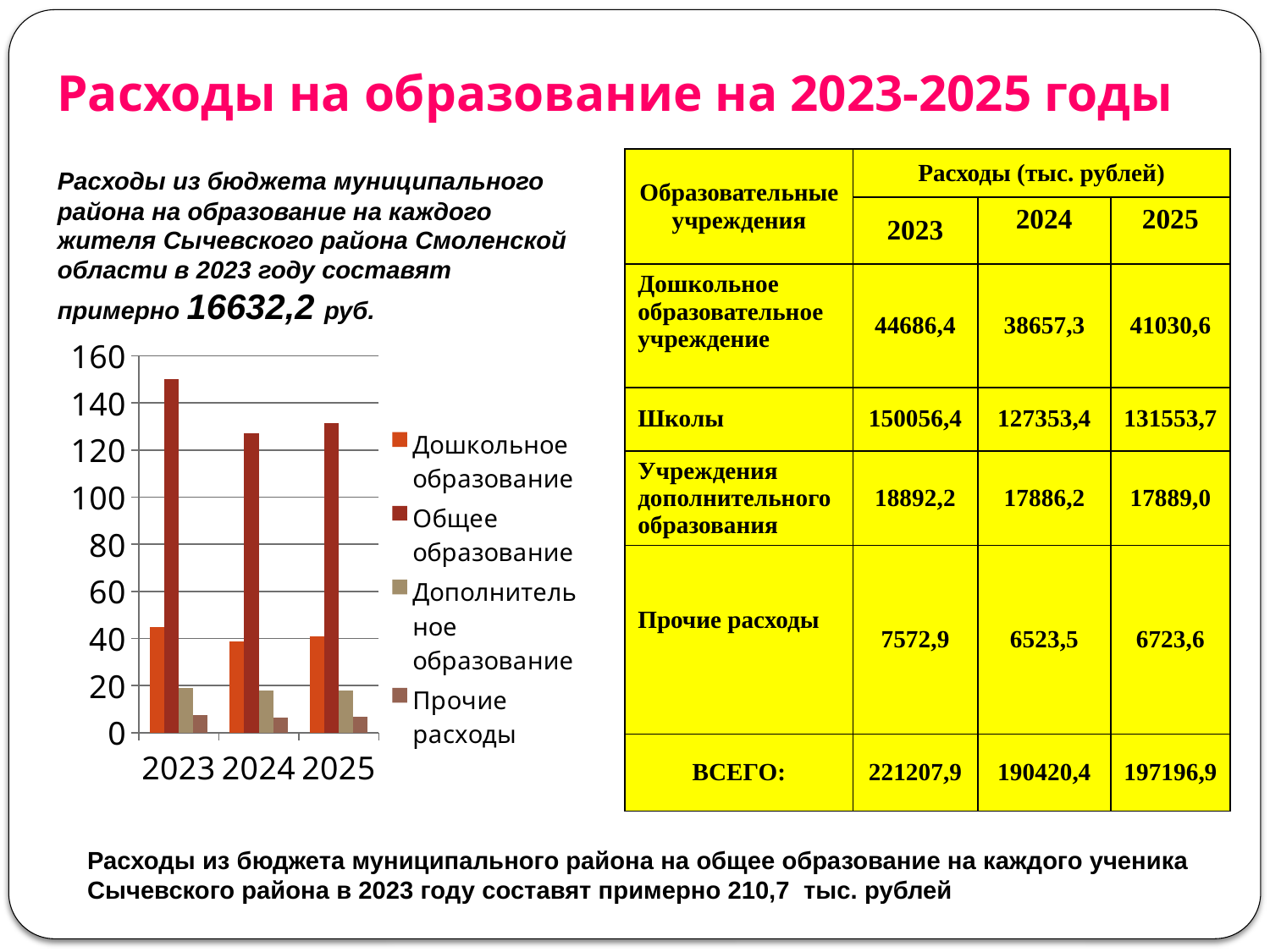
In 2023, which is larger: Дошкольное образование or Дополнительное образование? Дошкольное образование Which series has the lowest bars in every year of the chart? Прочие расходы Which series has the tallest bar in the chart? Общее образование How many years (categories) are shown on the x axis of the chart? 3 Is the value for Общее образование in 2023 greater or less than 140? greater How many series does the chart legend list? 4 Is the value for Общее образование in 2024 greater or less than 140? less What kind of chart is shown on the slide? bar chart Does the value for Общее образование rise or fall from 2023 to 2024? fall Which legend entry is shown in the darkest red colour? Общее образование